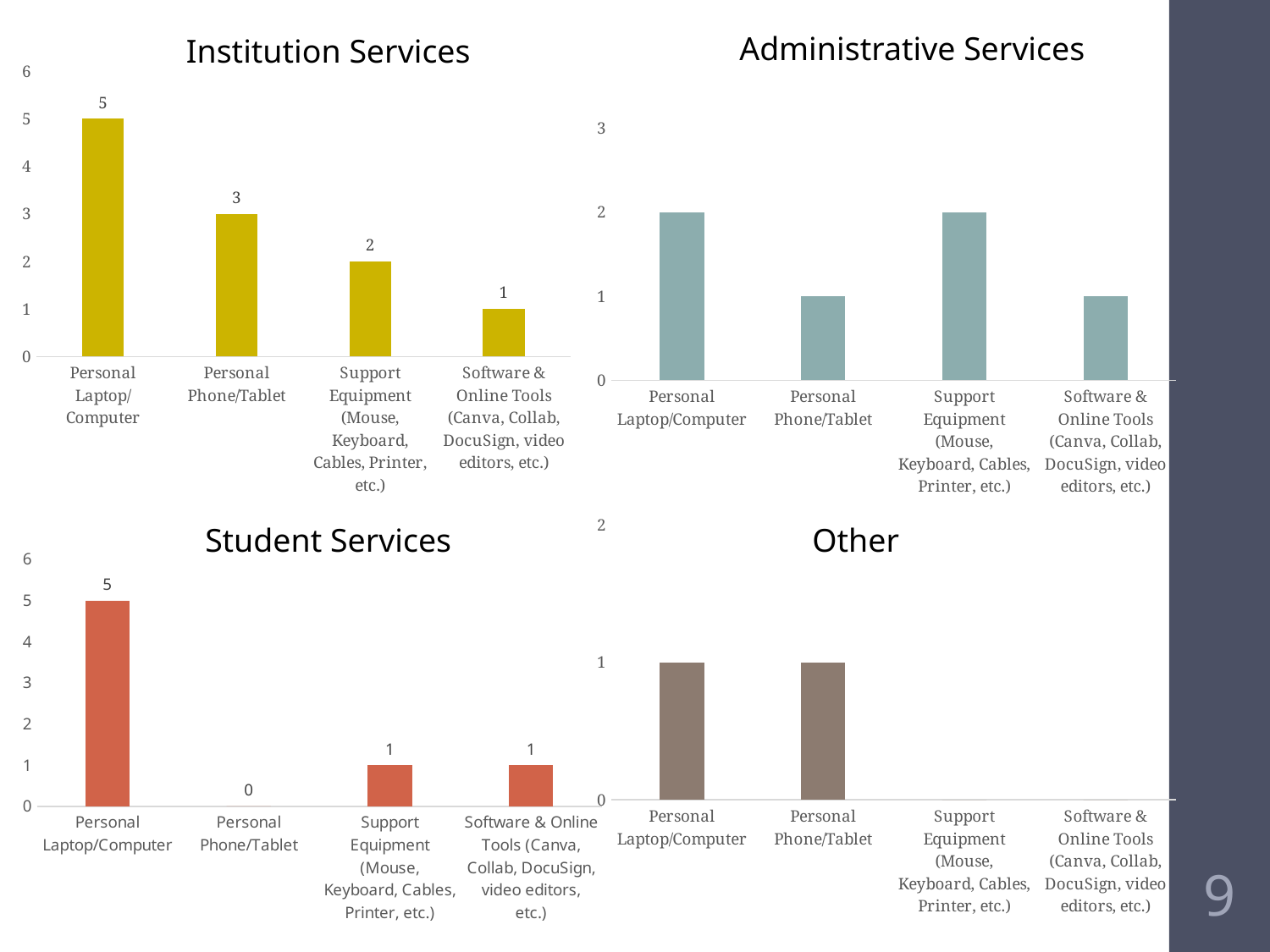
In the Administrative Services chart, what is the value for Support Equipment (Mouse, Keyboard, Cables, Printer, etc.)? 2 How many categories are shown on the x axis of the Other chart? 4 In the Other chart, what is the value for Personal Phone/Tablet? 1 In the Institution Services chart, what is the difference between Personal Phone/Tablet and Support Equipment? 1 In the Administrative Services chart, which is larger, Personal Laptop/Computer or Personal Phone/Tablet? Personal Laptop/Computer In the Student Services chart, what is the difference between Personal Laptop/Computer and Support Equipment? 4 In the Institution Services chart, which category has the lowest value? Software & Online Tools (Canva, Collab, DocuSign, video editors, etc.) In the Student Services chart, what is the value for Personal Phone/Tablet? 0 In the Student Services chart, which category has the highest value? Personal Laptop/Computer In the Institution Services chart, what is the value for Personal Laptop/Computer? 5 What kind of chart is the Student Services chart? bar chart In the Institution Services chart, do the values rise or fall from left to right along the x axis? fall